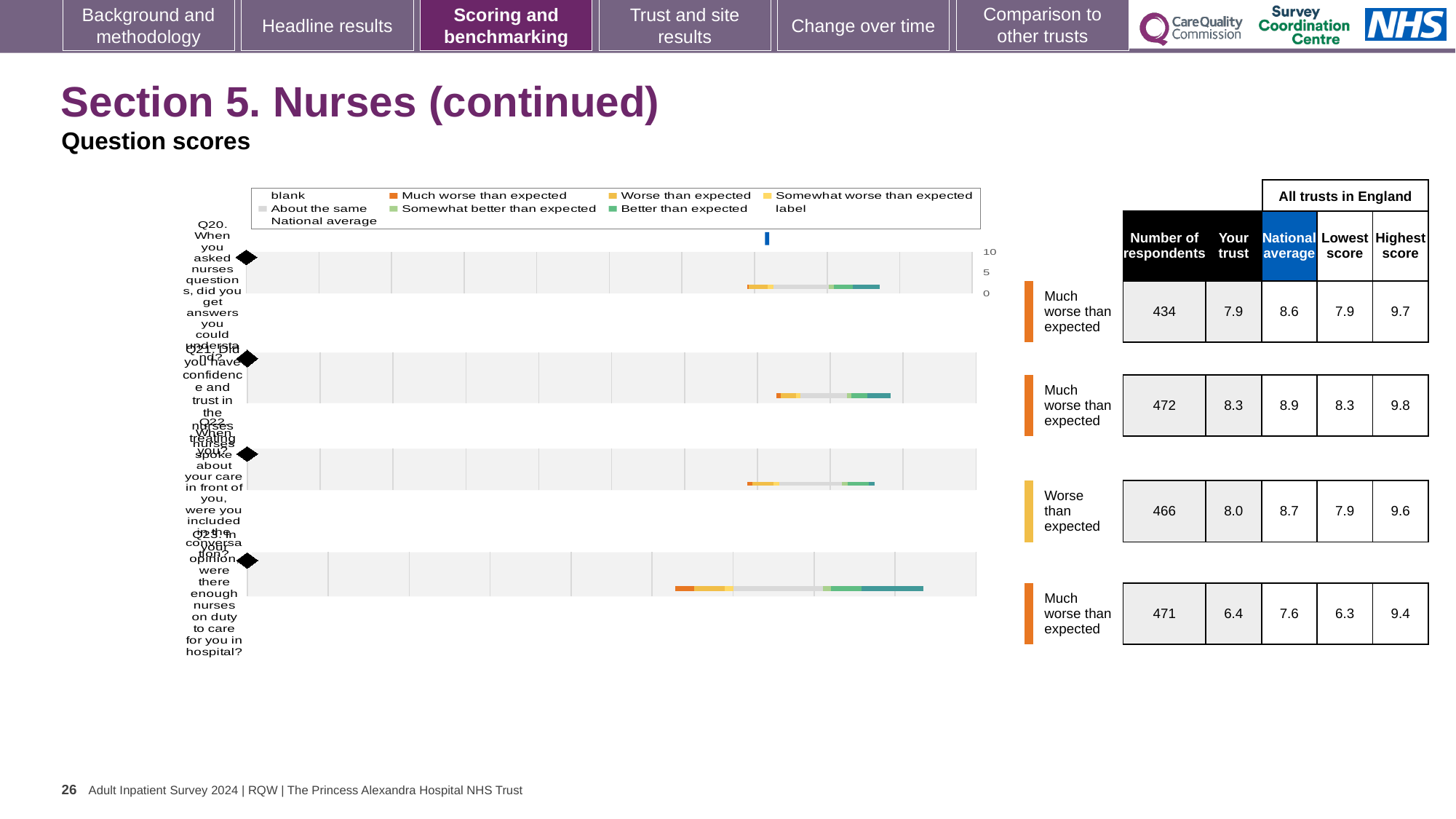
How many questions (categories) are plotted in the chart? 4 What is the national average score for Q21 (Did you have confidence and trust in the nurses treating you)? 8.9 Which question has the highest 'Your trust' score? Q21 Which question has the lowest 'Your trust' score? Q25 Which question has the largest number of respondents? Q21 What is the difference between the national average and the 'Your trust' score for Q25? 1.2 What is the number of respondents for Q22 (When nurses spoke about your care in front of you, were you included in the conversation)? 466 What is the 'Your trust' score for Q20 (When you asked nurses questions, did you get answers you could understand)? 7.9 What benchmark category is shown for Q22? Worse than expected For Q20, which is larger: the 'Your trust' score or the national average? National average What kind of chart is shown on the slide? bar chart What is the highest score among all trusts in England for Q25 (In your opinion, were there enough nurses on duty to care for you in hospital)? 9.4